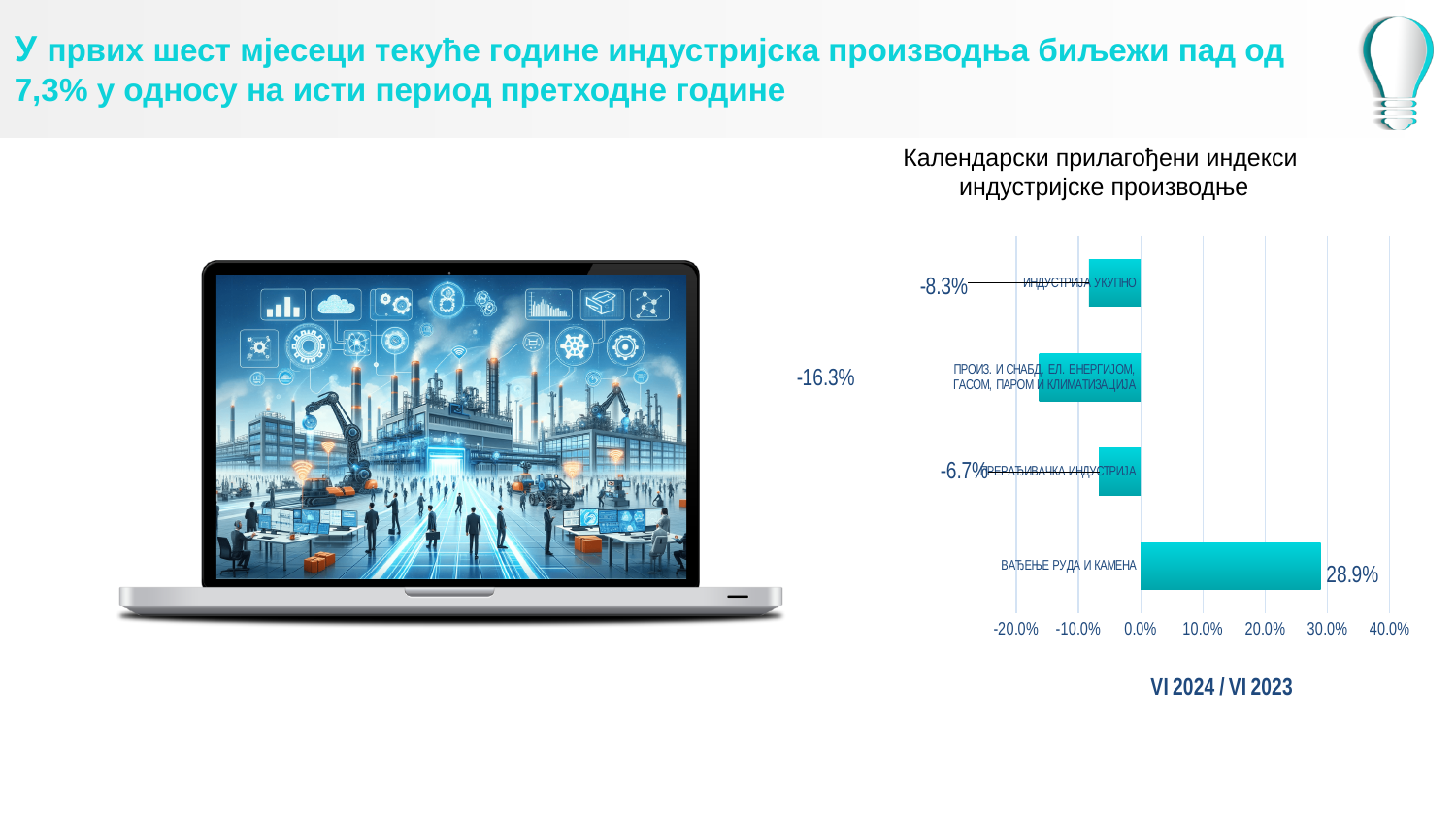
What is the value for ВАЂЕЊЕ РУДА И КАМЕНА? 28.9% Which is larger, the value for ИНДУСТРИЈА УКУПНО or the value for ПРЕРАЂИВАЧКА ИНДУСТРИЈА? ПРЕРАЂИВАЧКА ИНДУСТРИЈА What is the value for ПРОИЗ. И СНАБД. ЕЛ. ЕНЕРГИЈОМ, ГАСОМ, ПАРОМ И КЛИМАТИЗАЦИЈА? -16.3% What is the difference between the values for ВАЂЕЊЕ РУДА И КАМЕНА and ИНДУСТРИЈА УКУПНО? 37.2 percentage points What is the title of the chart? Календарски прилагођени индекси индустријске производње What period comparison does the chart legend show? VI 2024 / VI 2023 What is the value for ПРЕРАЂИВАЧКА ИНДУСТРИЈА? -6.7% Which category has the lowest value? ПРОИЗ. И СНАБД. ЕЛ. ЕНЕРГИЈОМ, ГАСОМ, ПАРОМ И КЛИМАТИЗАЦИЈА What is the value for ИНДУСТРИЈА УКУПНО? -8.3% Which category has the highest value? ВАЂЕЊЕ РУДА И КАМЕНА How many categories are shown in the chart? 4 What type of chart is shown on the slide? bar chart